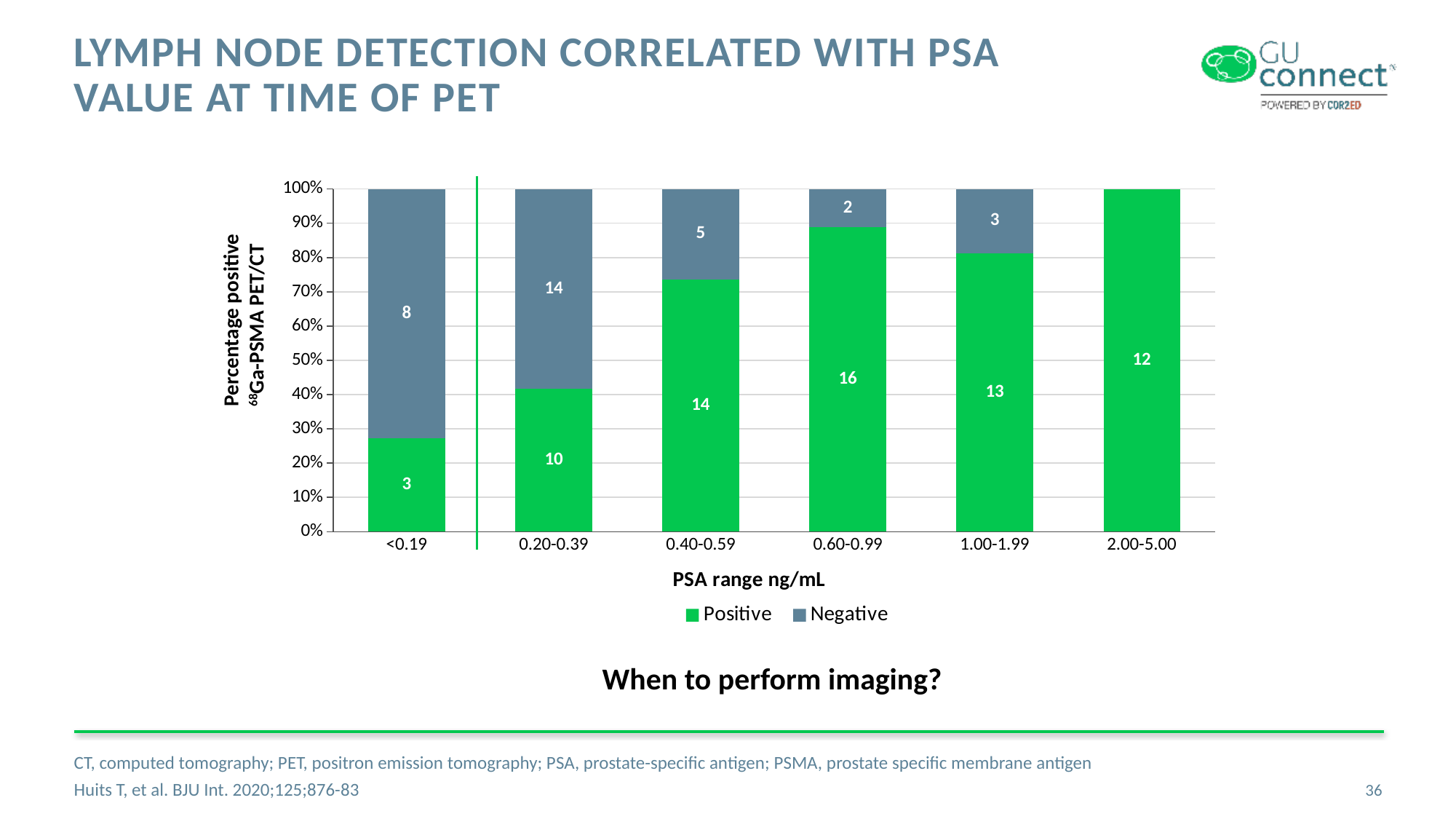
What is the Positive data label for the 0.60-0.99 PSA range? 16 What is the Negative data label for the 0.20-0.39 PSA range? 14 Is the Positive share of the bar for the 0.20-0.39 PSA range greater or less than 50%? less What kind of chart is shown on the slide? Stacked bar chart What is the total of the Positive and Negative labels for the 0.20-0.39 PSA range? 24 Which PSA range has the highest Positive data label? 0.60-0.99 How many series does the legend list? 2 Which PSA range has the lowest Positive data label? <0.19 Is the Positive share of the bar for the 0.60-0.99 PSA range greater or less than 80%? greater For the <0.19 PSA range, how much larger is the Negative label than the Positive label? 5 Which has the larger Positive data label: the 0.40-0.59 range or the 1.00-1.99 range? 0.40-0.59 How many PSA range categories are shown on the x axis? 6